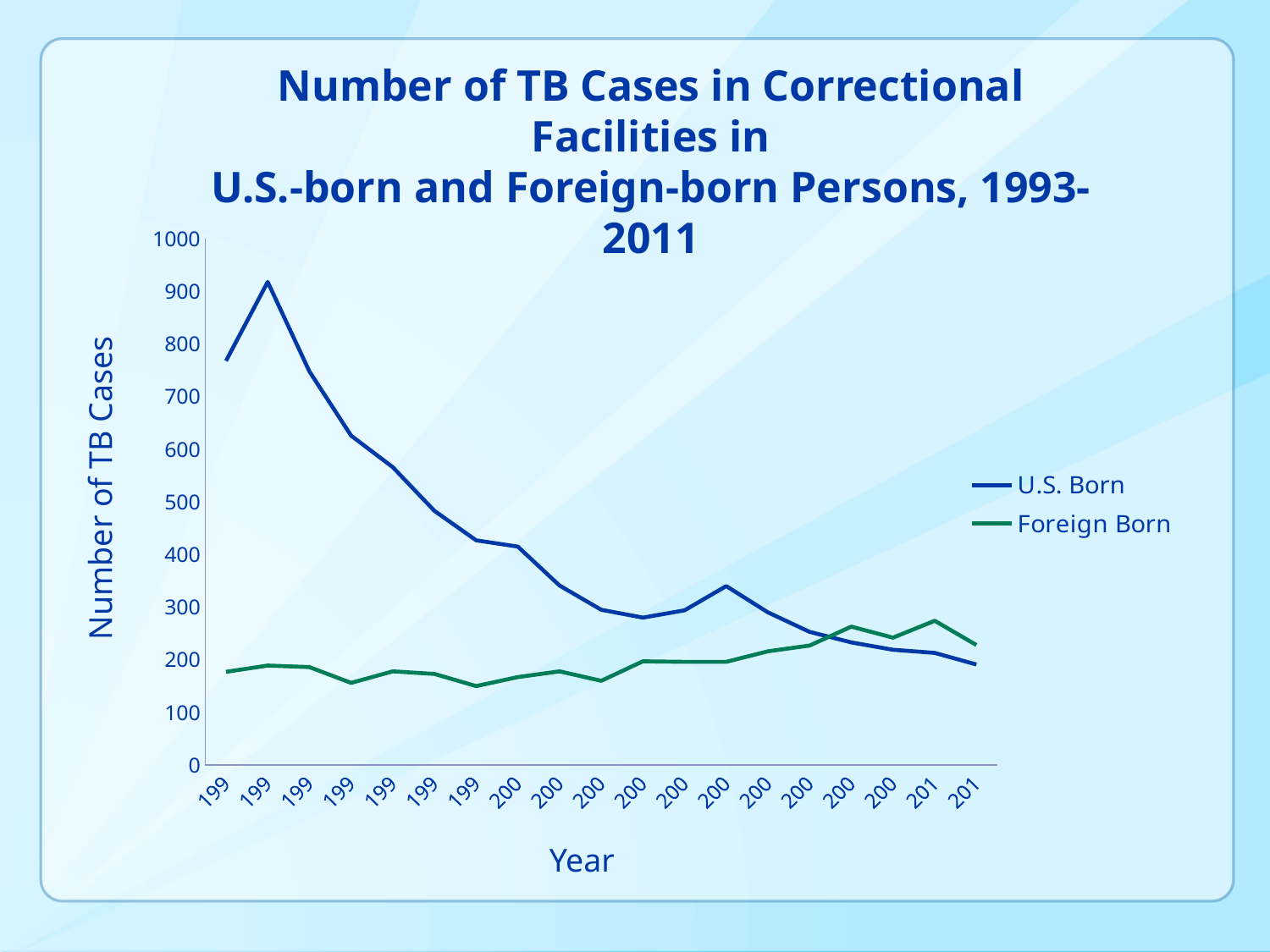
Is the first value of the U.S. Born line greater or less than 700? greater How many series does the legend list? 2 At the last point on the x axis, which series is higher, U.S. Born or Foreign Born? Foreign Born Is the peak value of the U.S. Born line greater or less than 800? greater What kind of chart is shown on the slide? line chart Does the Foreign Born line overall rise or fall from left to right? rise How many data points does each line have along the x axis? 19 Does the U.S. Born line overall rise or fall from left to right? fall What are the two series named in the legend? U.S. Born and Foreign Born Which series reaches the highest value on the chart? U.S. Born Is the last value of the U.S. Born line greater or less than 300? less What is the title of the y axis? Number of TB Cases